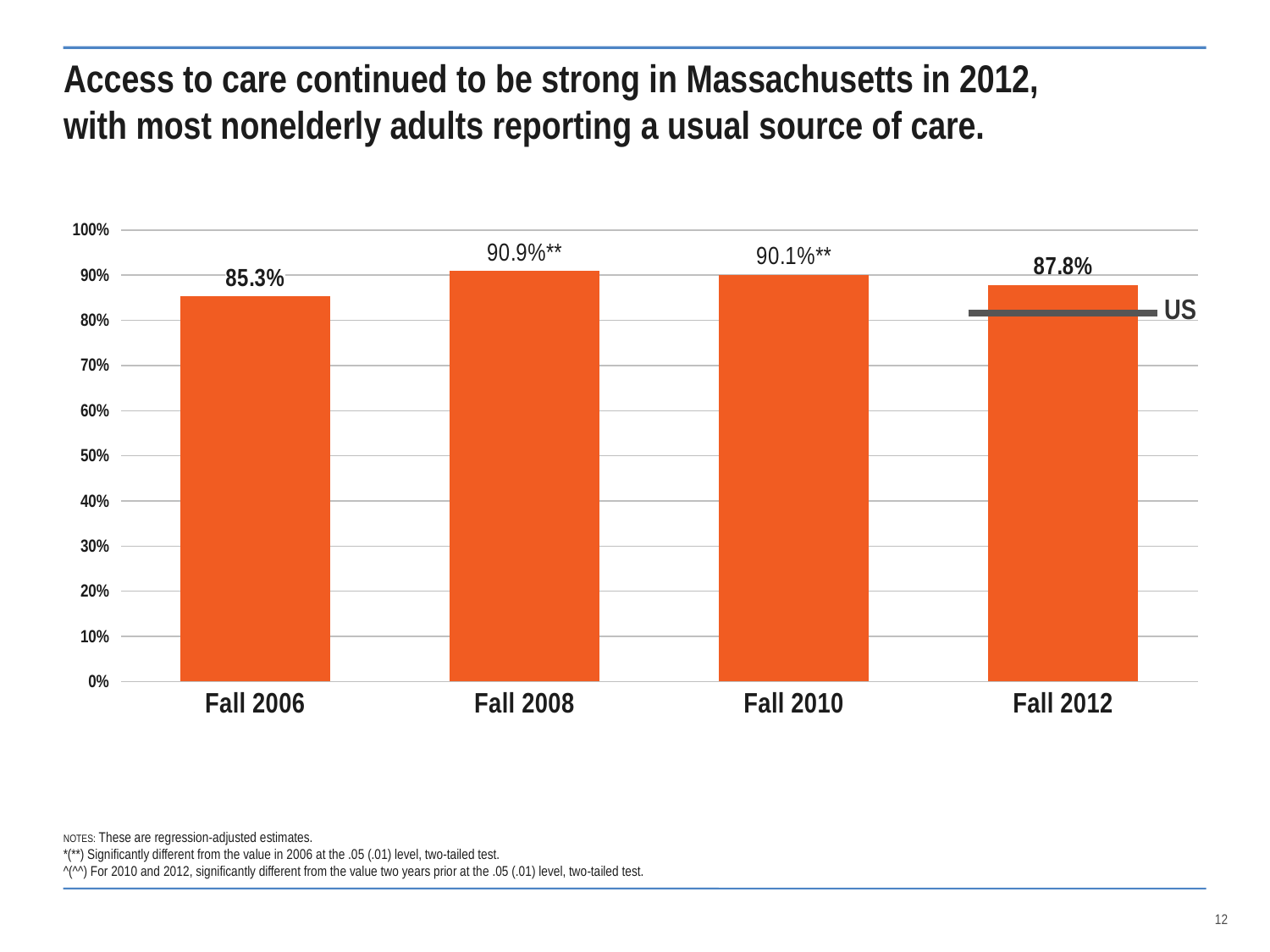
Which is larger, the value for Fall 2012 or the value for Fall 2006? Fall 2012 What kind of chart is shown on the slide? Bar chart What is the value for Fall 2010? 90.1% What is the difference between the Fall 2008 and Fall 2006 values? 5.6 percentage points How many periods are shown on the x axis? 4 Which period has the lowest value? Fall 2006 What is the value for Fall 2006? 85.3% Which period has the highest value? Fall 2008 What is the value for Fall 2012? 87.8% What label is attached to the horizontal reference line near the Fall 2012 bar? US Is the US reference line greater or less than 90%? less What is the value for Fall 2008? 90.9%